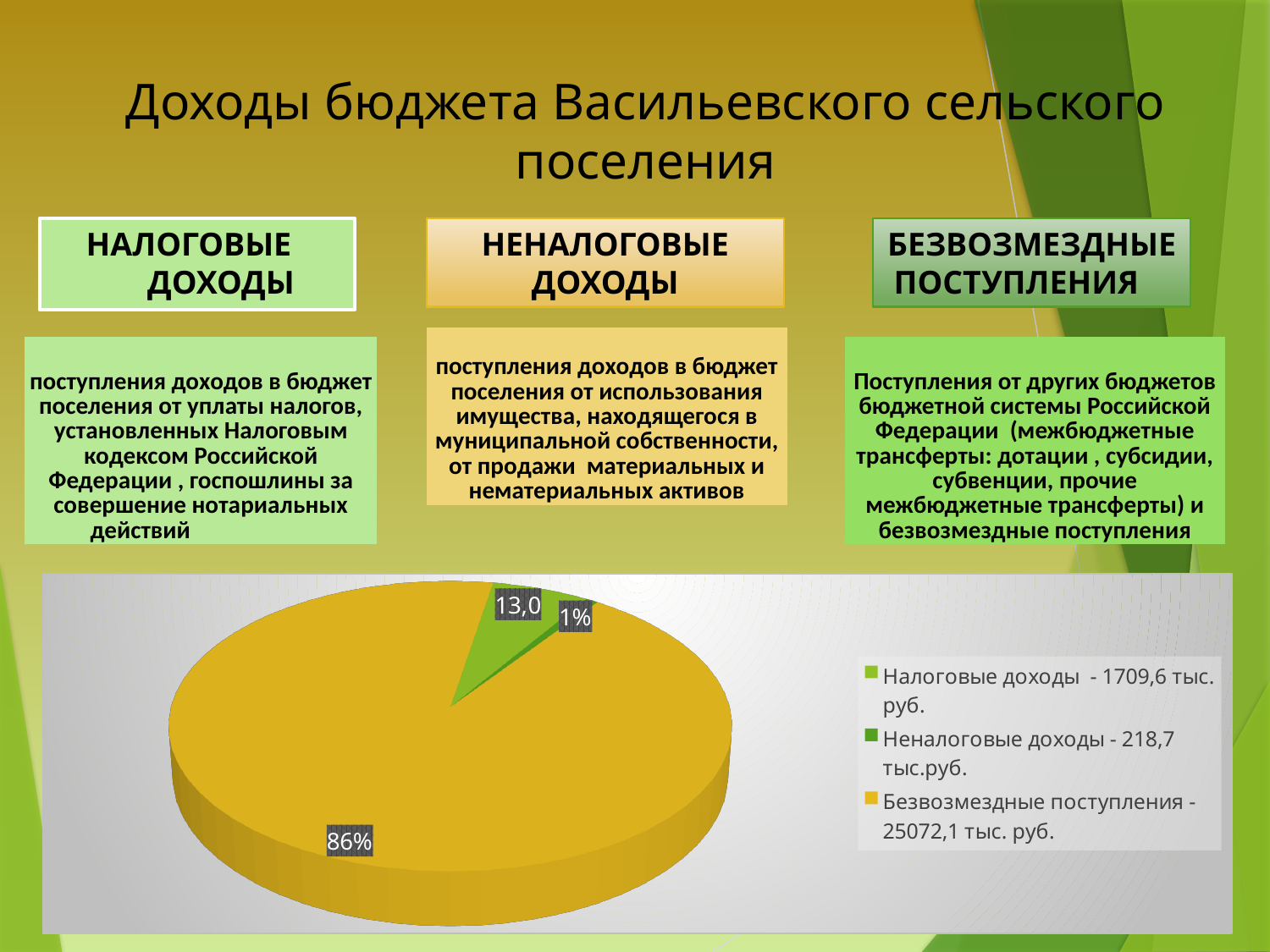
According to the legend, what amount is given for Налоговые доходы? 1709,6 тыс. руб. Which slice is larger: Налоговые доходы or Неналоговые доходы? Налоговые доходы What percentage label is shown on the slice for Безвозмездные поступления? 86% According to the legend, what amount is given for Безвозмездные поступления? 25072,1 тыс. руб. How many slices does the pie chart have? 3 What is the difference in percentage points between the labels for Безвозмездные поступления (86%) and Неналоговые доходы (1%)? 85% What kind of chart is shown at the bottom of the slide? pie chart How many entries does the pie chart's legend list? 3 Which category has the largest slice of the pie chart? Безвозмездные поступления What percentage label is shown on the slice for Неналоговые доходы? 1% Which category has the smallest slice of the pie chart? Неналоговые доходы What label is printed on the slice for Налоговые доходы? 13,0